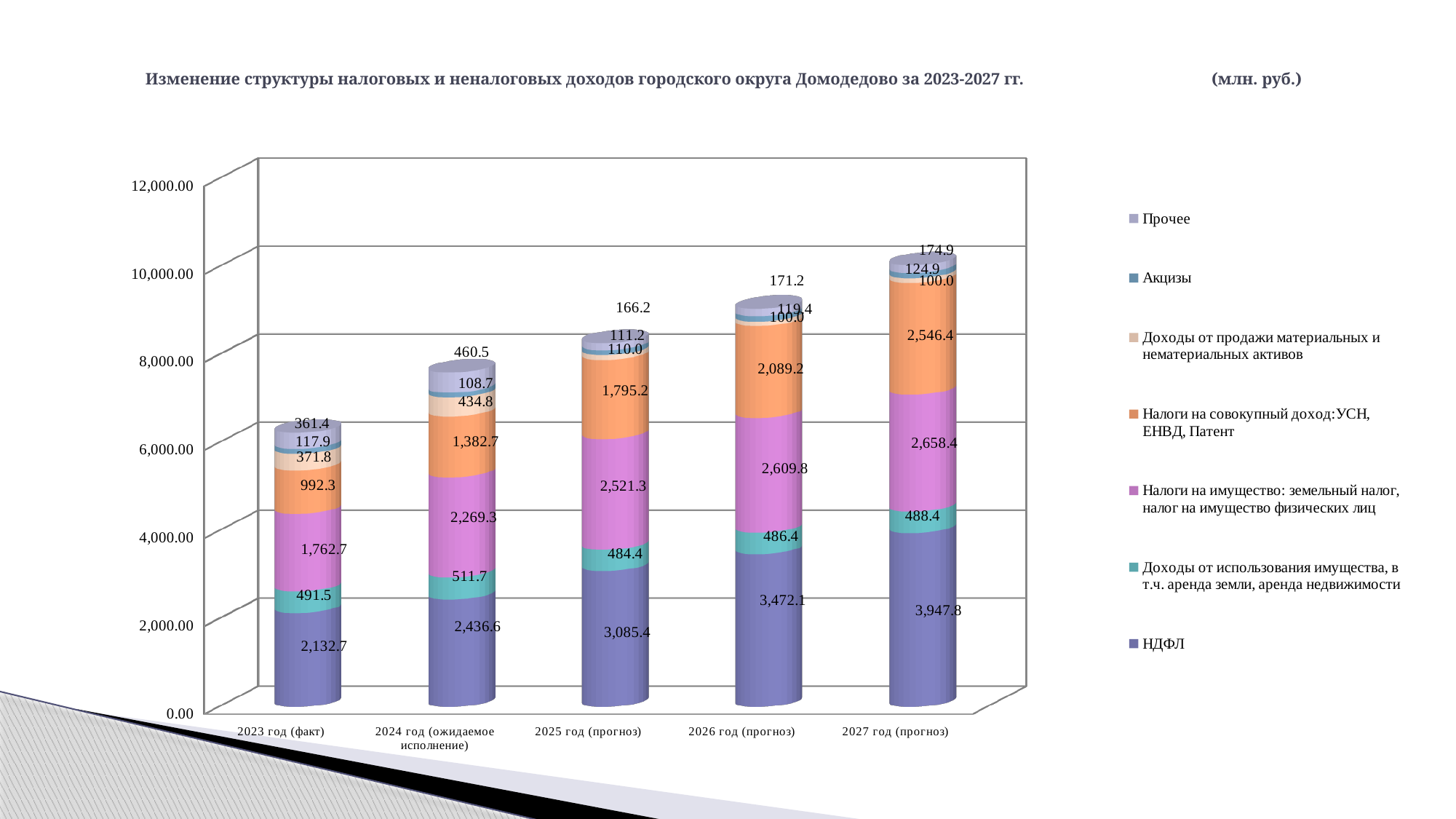
Is the total height of the bar for 2024 год (ожидаемое исполнение) greater or less than 8,000.00? less In which year is the НДФЛ value the highest? 2027 год (прогноз) What is the total of the stacked bar for 2023 год (факт)? 6,230.3 How many years (categories) are shown on the x axis? 5 Which year has the larger value for Доходы от использования имущества, в т.ч. аренда земли, аренда недвижимости: 2024 год (ожидаемое исполнение) or 2025 год (прогноз)? 2024 год (ожидаемое исполнение) By how much does НДФЛ in 2027 год (прогноз) exceed НДФЛ in 2023 год (факт)? 1,815.1 What is the value of Прочее for 2024 год (ожидаемое исполнение)? 460.5 How many series does the legend list? 7 What is the value of НДФЛ for 2023 год (факт)? 2,132.7 What is the value of Налоги на совокупный доход: УСН, ЕНВД, Патент for 2027 год (прогноз)? 2,546.4 What is the value of Налоги на имущество: земельный налог, налог на имущество физических лиц for 2025 год (прогноз)? 2,521.3 In which year is the value of Налоги на совокупный доход: УСН, ЕНВД, Патент the lowest? 2023 год (факт)